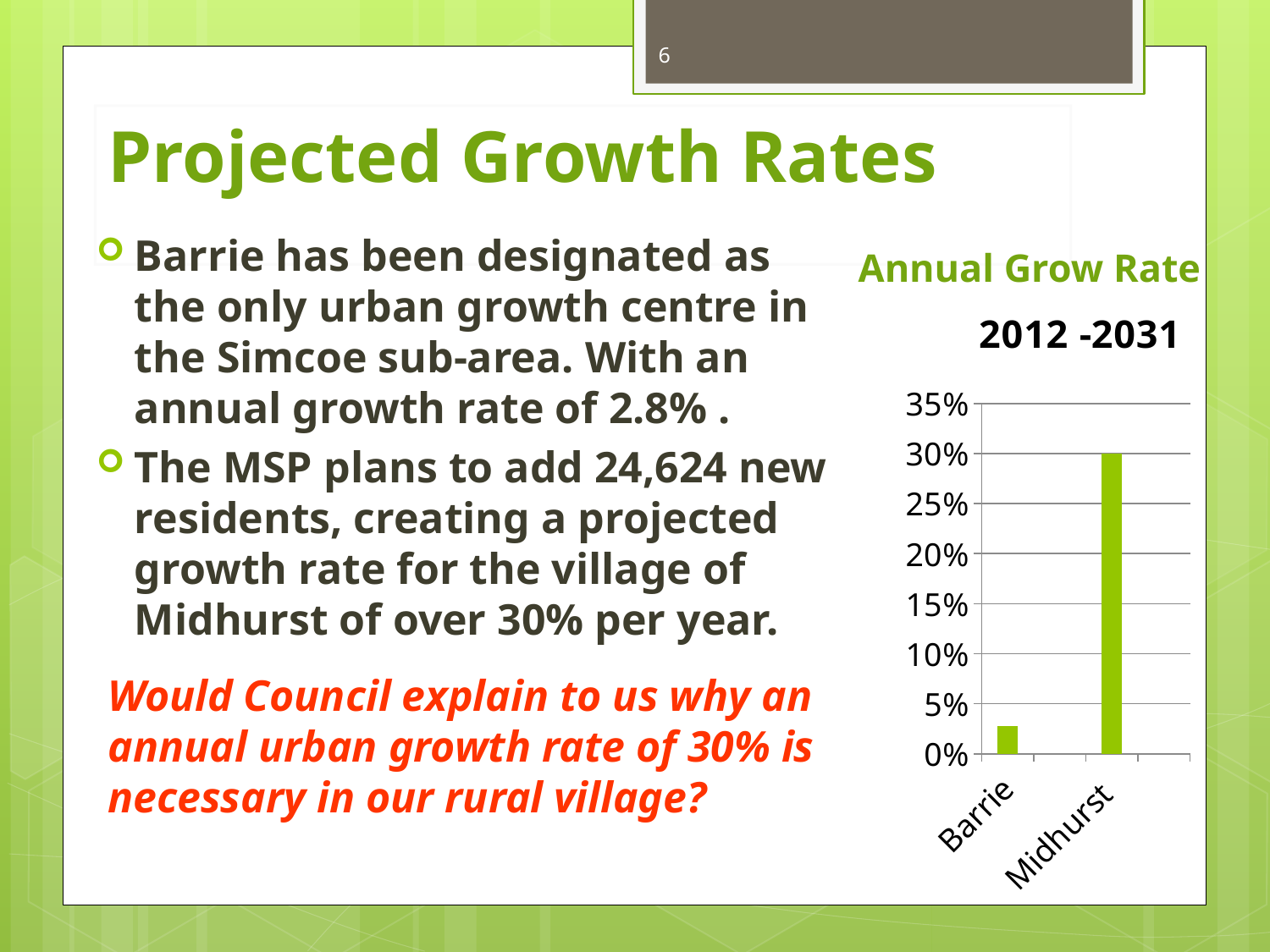
Is the value for Midhurst greater or less than 25%? greater What is the title of the chart? 2012 -2031 Do the values rise or fall moving from Barrie to Midhurst along the x axis? rise What kind of chart is shown on the slide? bar chart Is the value for Barrie greater or less than 5%? less What is the highest tick value shown on the chart's y axis? 35% What value does the Midhurst bar reach on the y axis? 30% Which has the larger value in the chart, Barrie or Midhurst? Midhurst How many categories are plotted in the chart? 2 Which category has the highest annual growth rate in the chart? Midhurst Which category has the lowest annual growth rate in the chart? Barrie